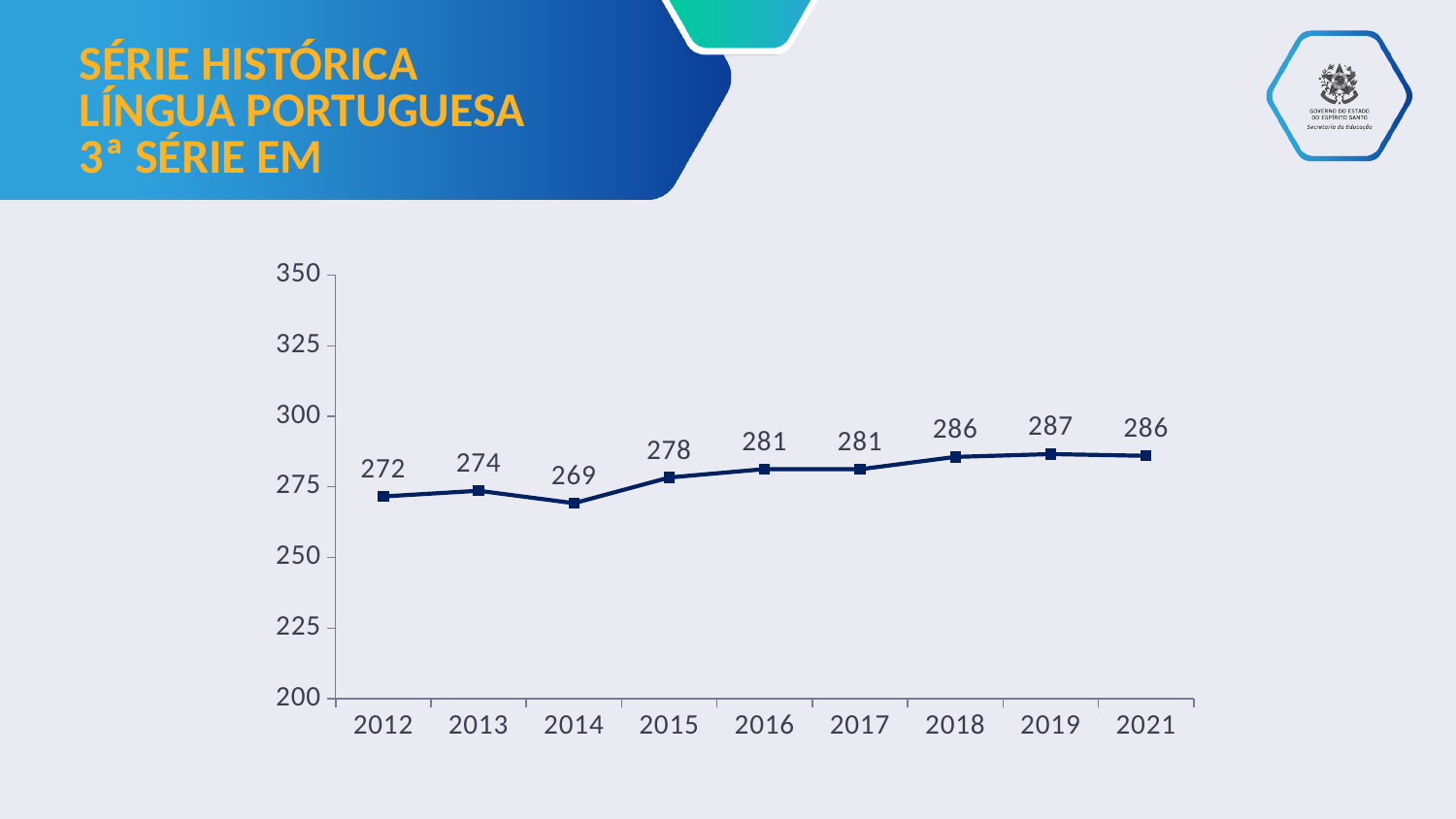
Is the value for 2017 greater or less than 300? less What is the value for 2012? 272 What is the value for 2014? 269 What is the difference between the values for 2019 and 2012? 15 What kind of chart is shown on the slide? line chart Which year has the highest value? 2019 Do the values generally rise or fall from 2012 to 2021? rise Which is larger, the value for 2015 or the value for 2018? 2018 Which year has the lowest value? 2014 How many years are plotted on the chart? 9 What is the value for 2021? 286 What is the title of the slide? SÉRIE HISTÓRICA LÍNGUA PORTUGUESA 3ª SÉRIE EM